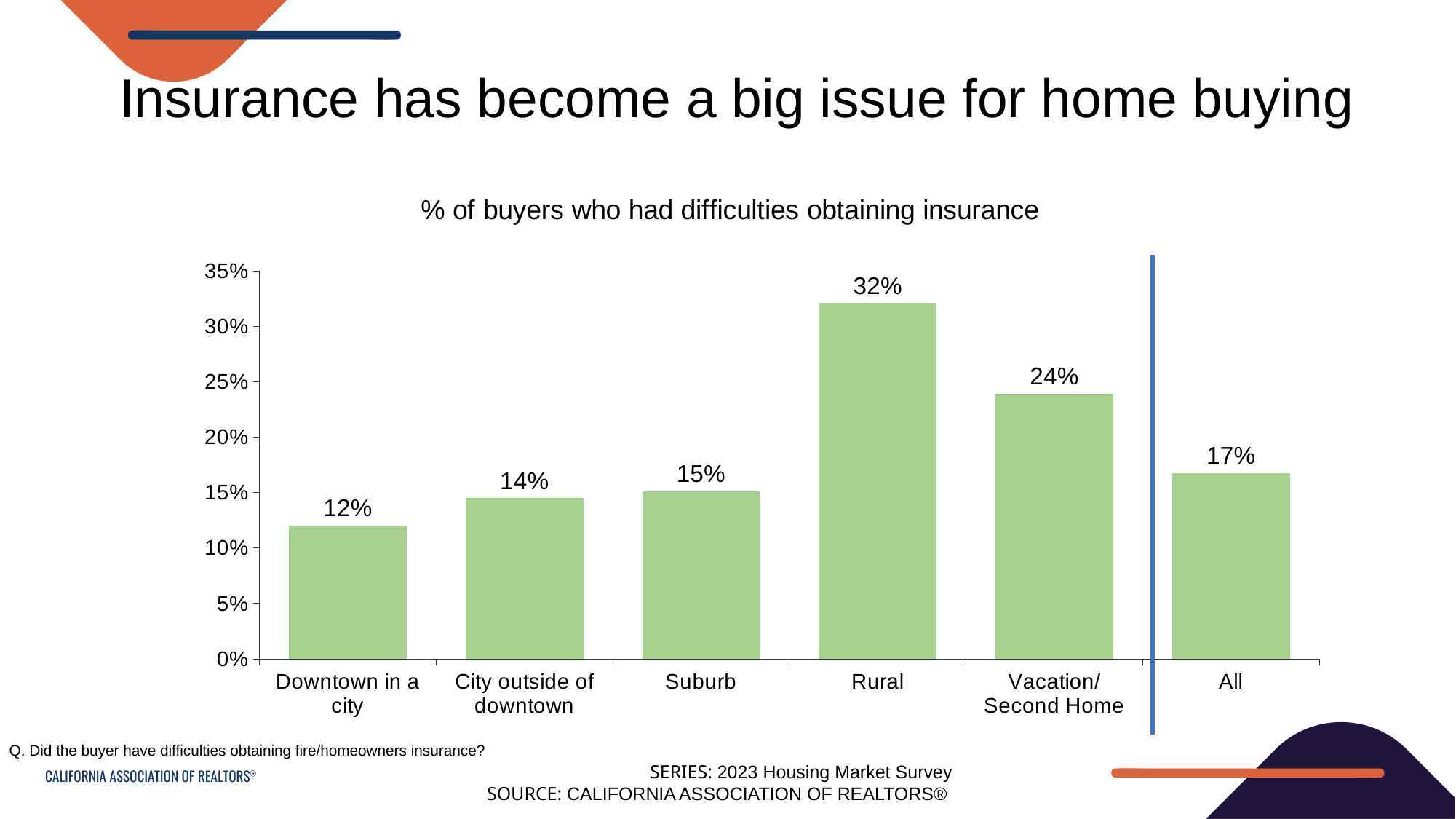
Which category has the lowest percentage of buyers with difficulties obtaining insurance? Downtown in a city Which category has the highest percentage of buyers with difficulties obtaining insurance? Rural What is the value shown for Downtown in a city? 12% What is the value shown for the All category? 17% What kind of chart is shown on the slide? Bar chart What is the value shown for Vacation/Second Home? 24% Is the value for Rural greater or less than 30%? greater What is the difference between the Rural value and the Suburb value? 17% What percentage of Rural buyers had difficulties obtaining insurance? 32% How many categories are shown on the x axis of the chart? 6 Which is larger, the value for Vacation/Second Home or the value for City outside of downtown? Vacation/Second Home What is the title of the chart? % of buyers who had difficulties obtaining insurance